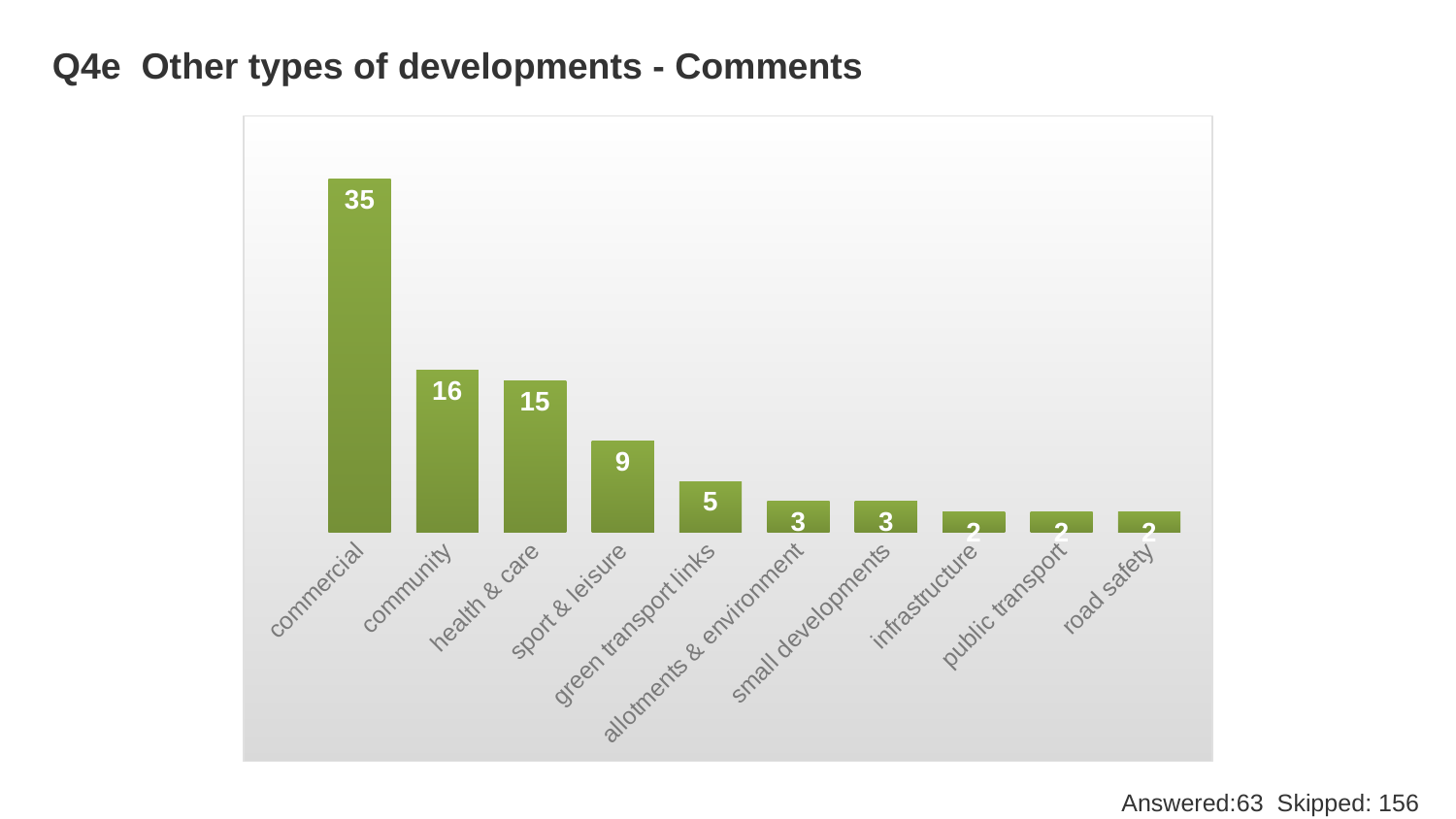
Do the values rise or fall from left to right along the x axis? fall Which category has the highest value? commercial What is the value for health & care? 15 What is the difference between the values for commercial and community? 19 What is the title of the slide? Q4e Other types of developments - Comments What is the value for green transport links? 5 How many categories are shown in the chart? 10 Which is larger, the value for sport & leisure or the value for green transport links? sport & leisure What kind of chart is shown on the slide? bar chart What is the value for commercial? 35 What is the value for sport & leisure? 9 What is the difference between the values for community and health & care? 1